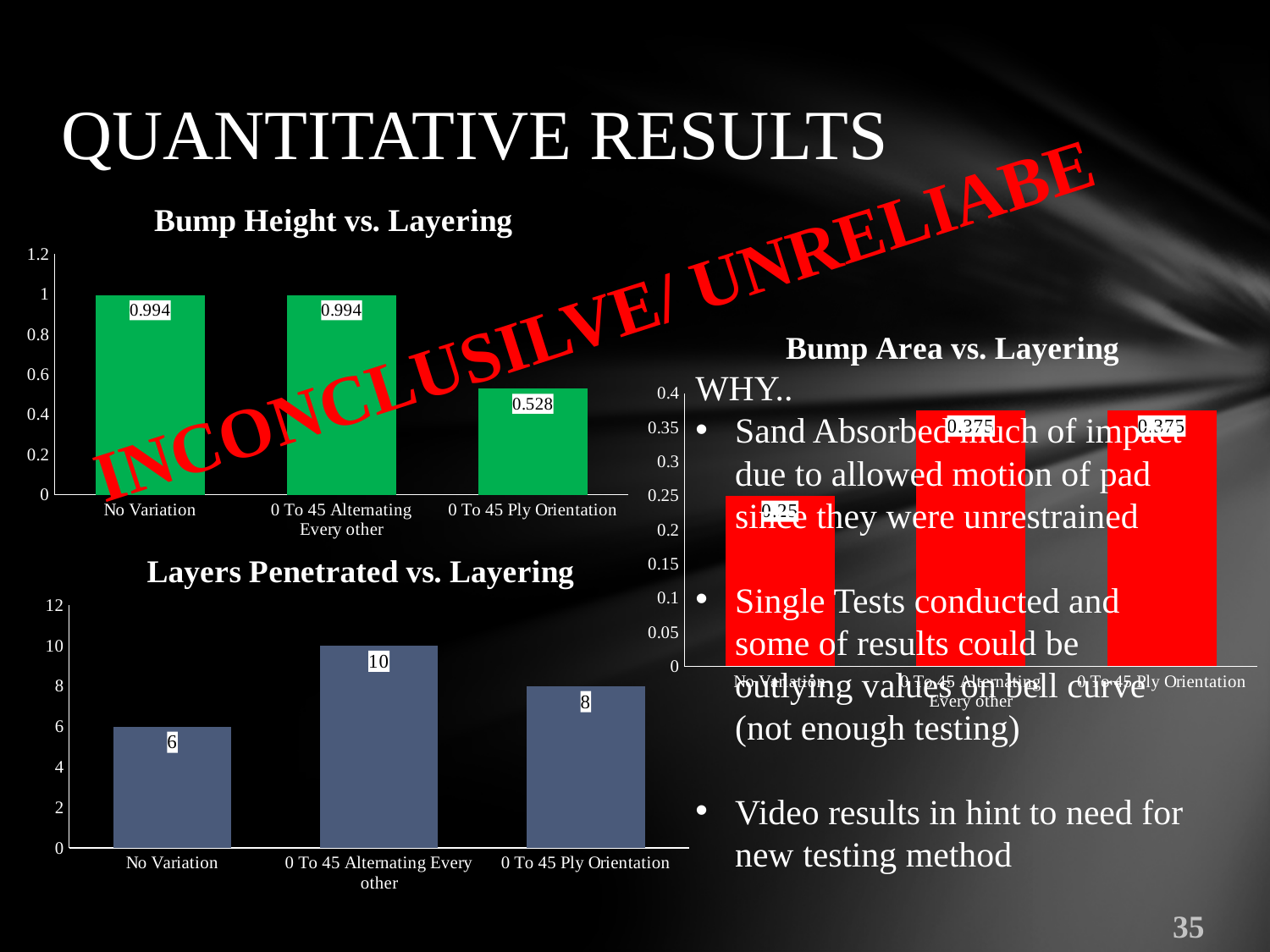
In the Layers Penetrated vs. Layering chart, what is the difference between the values for 0 To 45 Alternating Every other and No Variation? 4 What kind of chart is the Bump Area vs. Layering chart? Bar chart In the Layers Penetrated vs. Layering chart, what is the value for 0 To 45 Alternating Every other? 10 In the Bump Area vs. Layering chart, what is the value for No Variation? 0.25 In the Bump Height vs. Layering chart, which category has the lowest value? 0 To 45 Ply Orientation In the Layers Penetrated vs. Layering chart, which category has the highest value? 0 To 45 Alternating Every other In the Bump Height vs. Layering chart, what is the value for 0 To 45 Ply Orientation? 0.528 In the Bump Height vs. Layering chart, what is the value for No Variation? 0.994 How many categories are shown in the Layers Penetrated vs. Layering chart? 3 In the Bump Height vs. Layering chart, what is the difference between the values for No Variation and 0 To 45 Ply Orientation? 0.466 In the Bump Area vs. Layering chart, which is larger, the value for No Variation or the value for 0 To 45 Ply Orientation? 0 To 45 Ply Orientation In the Layers Penetrated vs. Layering chart, which category has the lowest value? No Variation